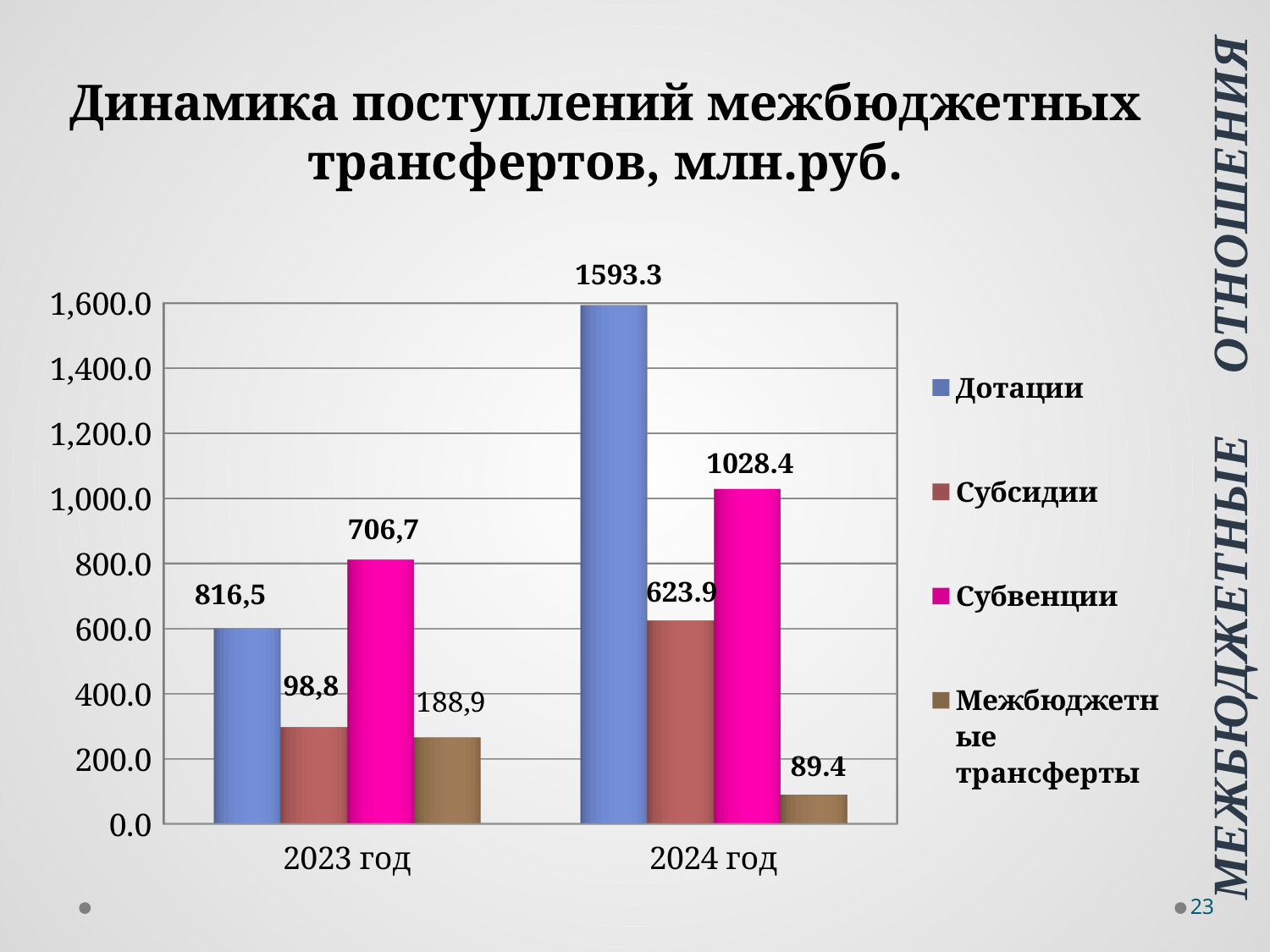
What is the value for Межбюджетные трансферты in 2024 год? 89.4 How many series does the legend list? 4 Which series has the lowest value in 2024 год? Межбюджетные трансферты Which is larger in 2024 год, Субсидии or Субвенции? Субвенции What kind of chart is shown on the slide? Bar chart Is the value for Дотации in 2024 год greater or less than 1,400.0? greater What is the data label shown for Субвенции in 2023 год? 706,7 What is the value for Субсидии in 2024 год? 623.9 What is the value for Субвенции in 2024 год? 1028.4 What is the value for Дотации in 2024 год? 1593.3 What is the difference between Дотации and Субвенции in 2024 год? 564.9 Which series has the highest value in 2024 год? Дотации